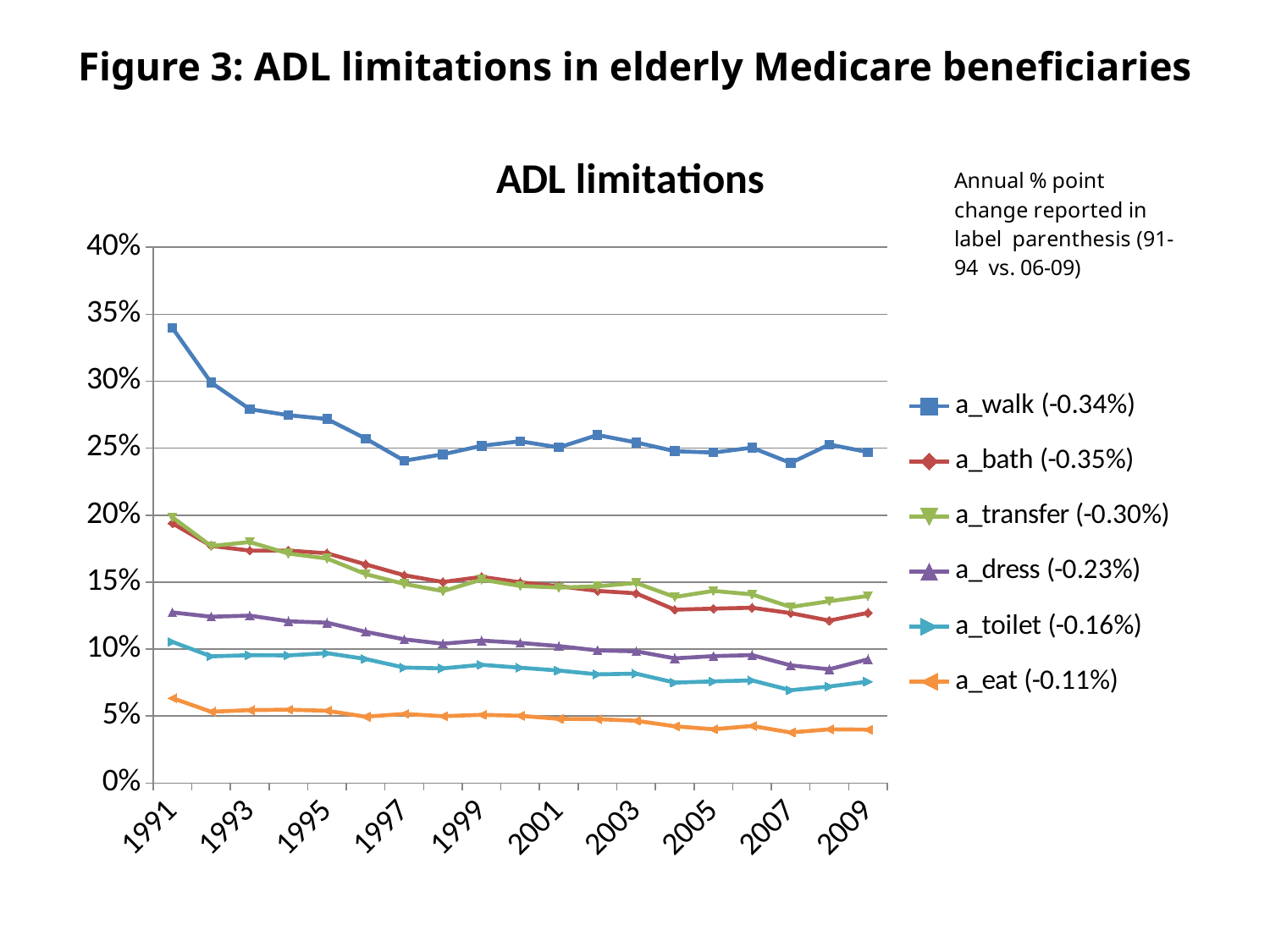
How many series does the legend list? 6 Is the value for a_walk in 1991 greater or less than 30%? greater What kind of chart is shown on the slide? line chart What is the title of the chart? ADL limitations Is the value for a_eat in 2009 greater or less than 5%? less Is the value for a_dress in 1991 greater or less than 10%? greater What annual % point change is reported in the legend for a_bath? -0.35% What annual % point change is reported in the legend for a_eat? -0.11% Do the values for a_walk rise or fall from 1991 to 2009? fall Which series has the lowest values across the whole period? a_eat Which series has the highest values across the whole period? a_walk